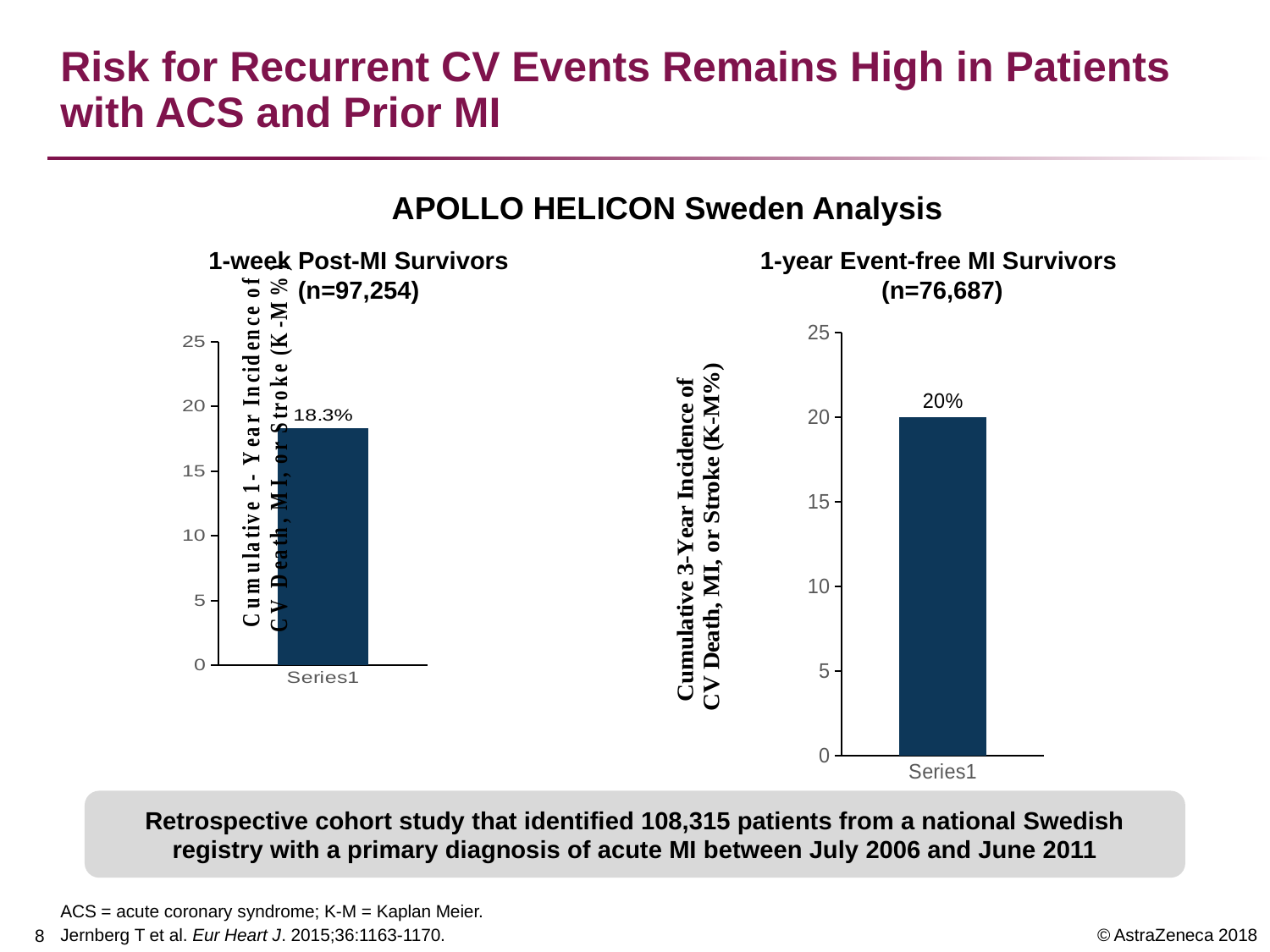
What is the maximum value shown on the y axis of the right chart (1-year Event-free MI Survivors)? 25 How many bars are plotted in the left chart (1-week Post-MI Survivors)? 1 What is the difference between the bar value in the right chart (20%) and the bar value in the left chart (18.3%)? 1.7% In the left chart (1-week Post-MI Survivors), what is the value shown on the bar? 18.3% What kind of chart is the left chart (1-week Post-MI Survivors)? Bar chart What kind of chart is the right chart (1-year Event-free MI Survivors)? Bar chart In the left chart (1-week Post-MI Survivors), is the value of the bar greater or less than 20? less What is the y-axis label of the right chart (1-year Event-free MI Survivors)? Cumulative 3-Year Incidence of CV Death, MI, or Stroke (K-M%) In the right chart (1-year Event-free MI Survivors), what is the value shown on the bar? 20% In the right chart (1-year Event-free MI Survivors), is the value of the bar greater or less than 15? greater Which chart shows the larger bar value: the left chart (1-week Post-MI Survivors) or the right chart (1-year Event-free MI Survivors)? 1-year Event-free MI Survivors How many bars are plotted in the right chart (1-year Event-free MI Survivors)? 1